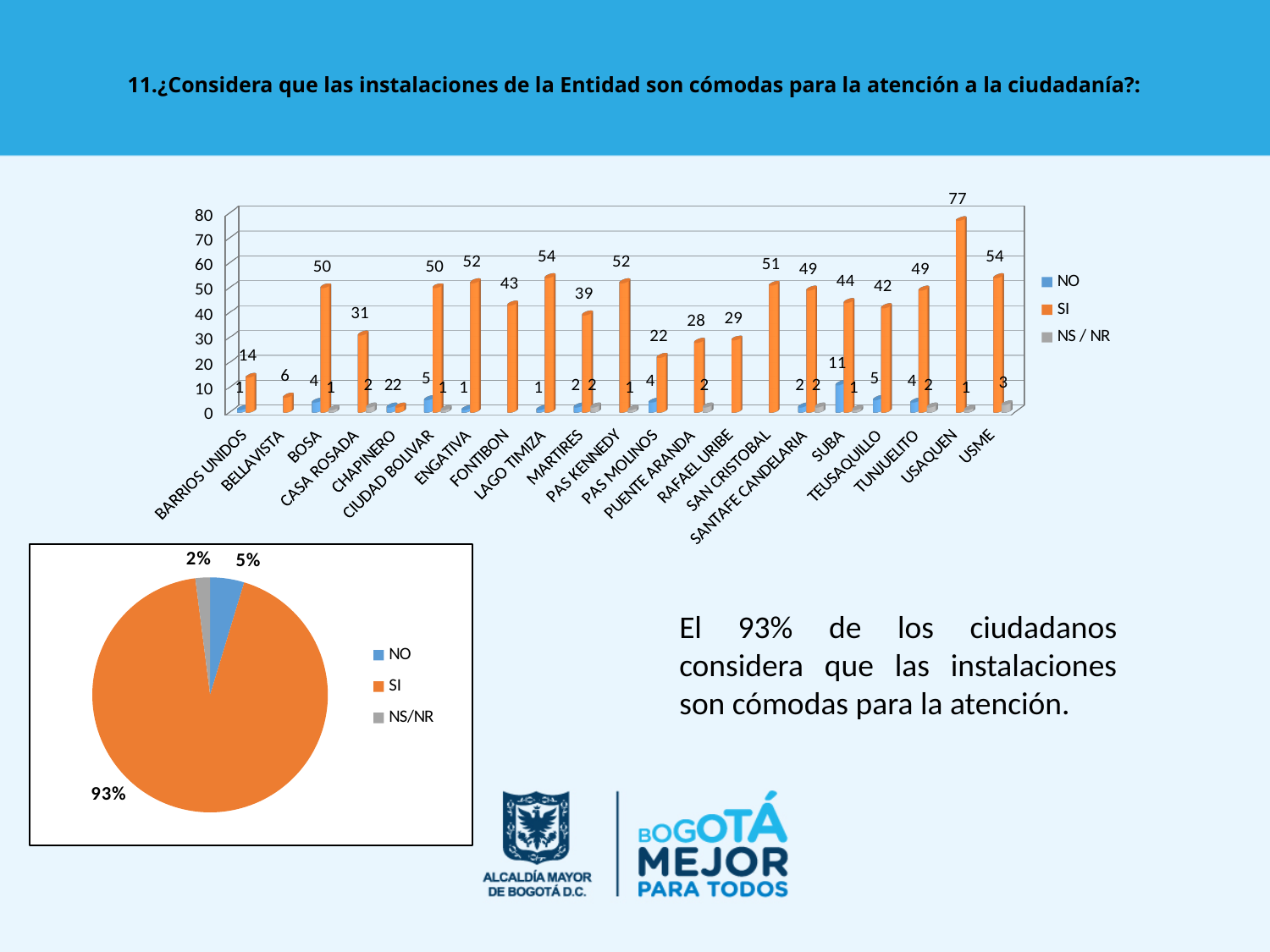
In the pie chart, which slice is the smallest? NS/NR How many series does the legend of the bar chart list? 3 In the bar chart, which category has the highest value for the SI series? USAQUEN How many categories are shown on the x axis of the bar chart? 21 In the bar chart, which has a larger SI value, LAGO TIMIZA or MARTIRES? LAGO TIMIZA In the bar chart, what is the NO value for SUBA? 11 In the pie chart, what share does SI have? 93% In the bar chart, what is the difference between the SI values for USAQUEN and USME? 23 In the pie chart, what share does NO have? 5% In the bar chart, what is the SI value for USAQUEN? 77 In the bar chart, what is the SI value for CASA ROSADA? 31 What kind of chart is the upper chart on the slide? Bar chart